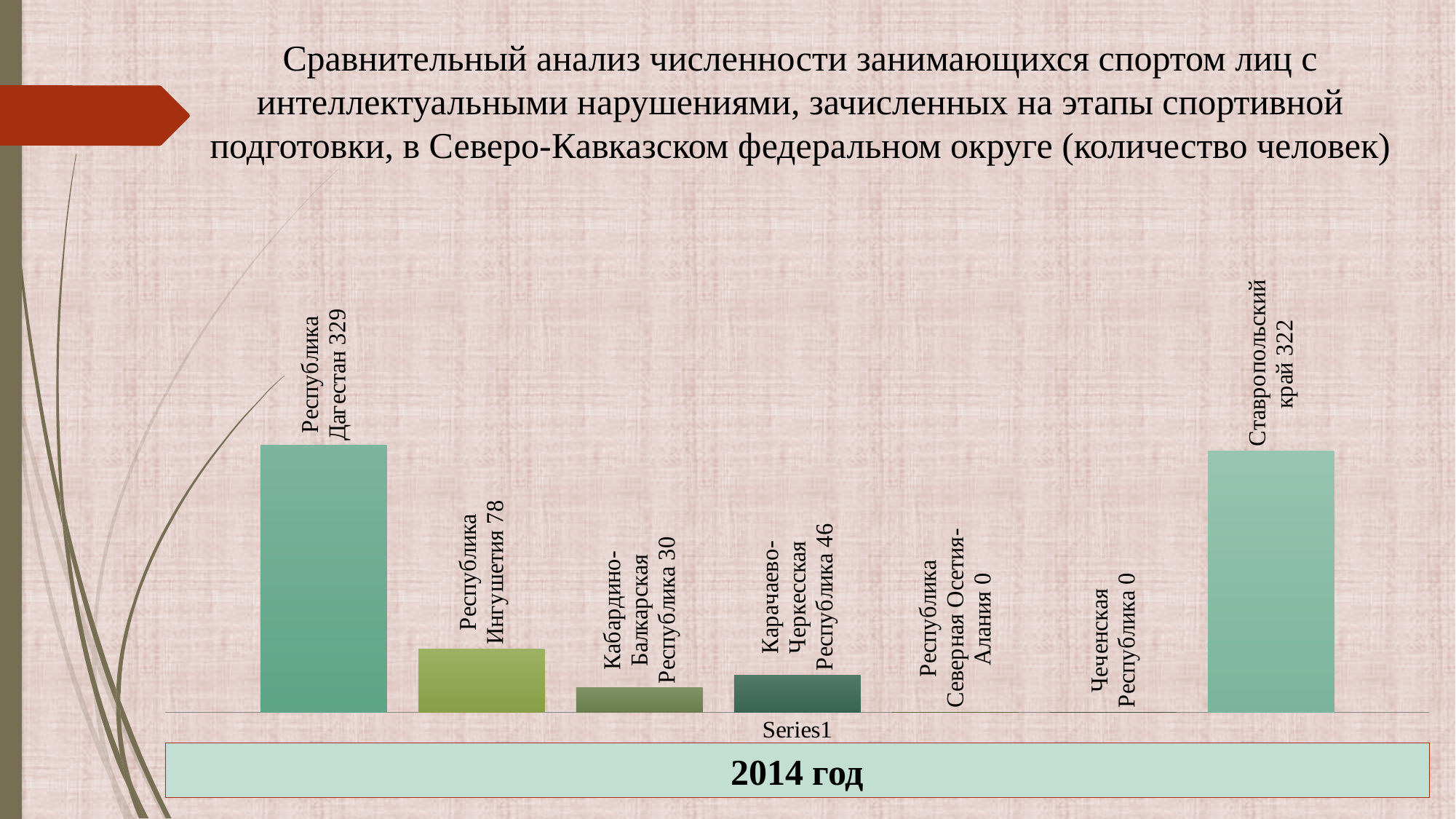
What is the value for Республика Дагестан? 329 What is the value for Ставропольский край? 322 How many regions are shown in the chart? 7 Which year does the chart refer to? 2014 год What is the difference between the values for Республика Дагестан and Ставропольский край? 7 What is the value for Республика Ингушетия? 78 What is the value for Карачаево-Черкесская Республика? 46 What is the difference between the values for Республика Ингушетия and Кабардино-Балкарская Республика? 48 Which is larger, the value for Карачаево-Черкесская Республика or Кабардино-Балкарская Республика? Карачаево-Черкесская Республика Which region has the highest value? Республика Дагестан What kind of chart is shown on the slide? bar chart How many regions have a value of 0? 2